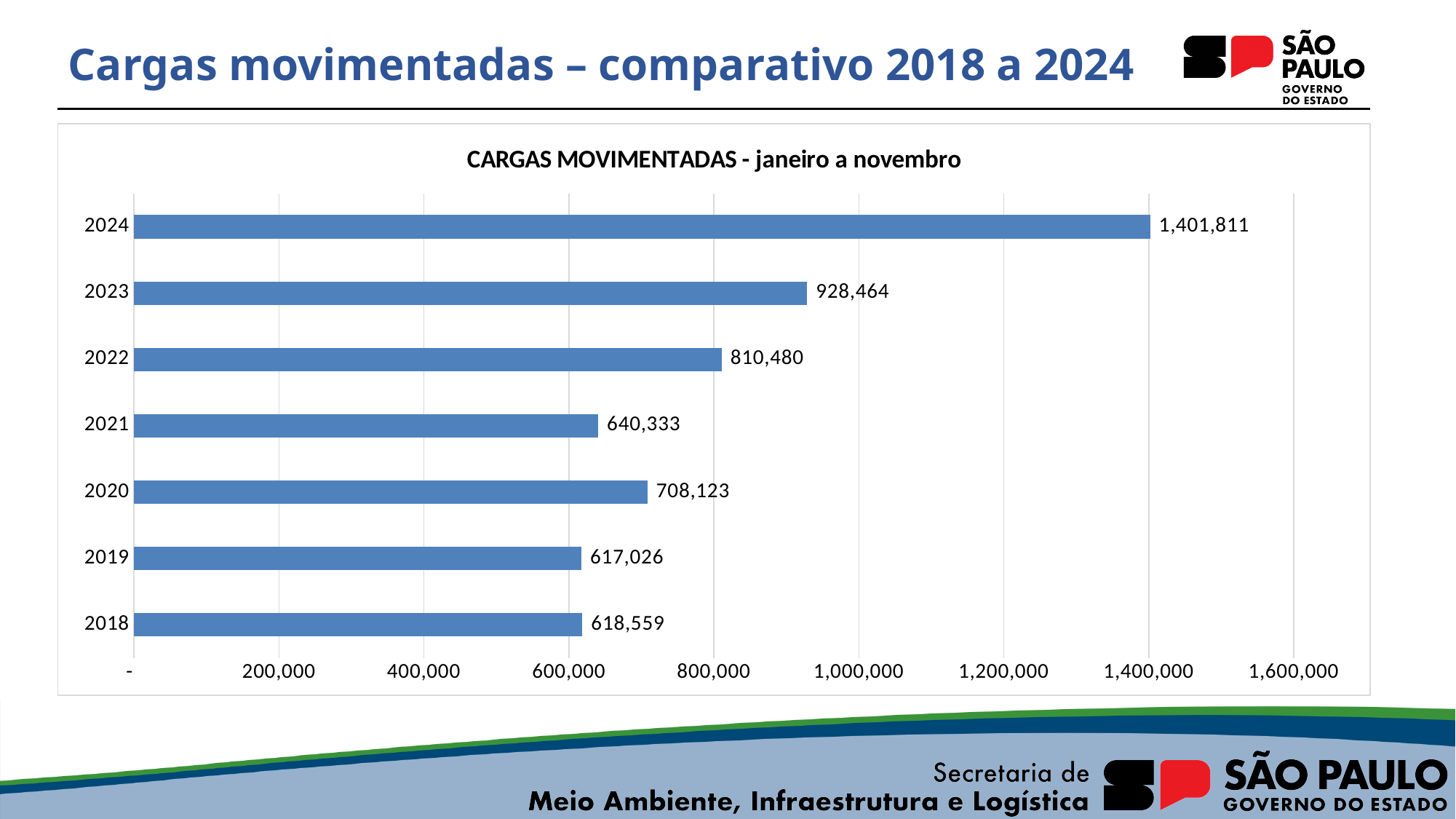
Which year has the highest value in the chart? 2024 What is the title of the chart? CARGAS MOVIMENTADAS - janeiro a novembro What is the value for 2024 in the chart? 1,401,811 What is the difference between the values for 2023 and 2022? 117,984 What is the value for 2021 in the chart? 640,333 What is the difference between the values for 2024 and 2023? 473,347 Is the value for 2023 greater or less than 800,000? greater What kind of chart is shown on the slide? bar chart Which is larger, the value for 2020 or the value for 2021? 2020 Is the value for 2021 greater or less than 800,000? less How many years are shown in the chart? 7 What is the value for 2018 in the chart? 618,559